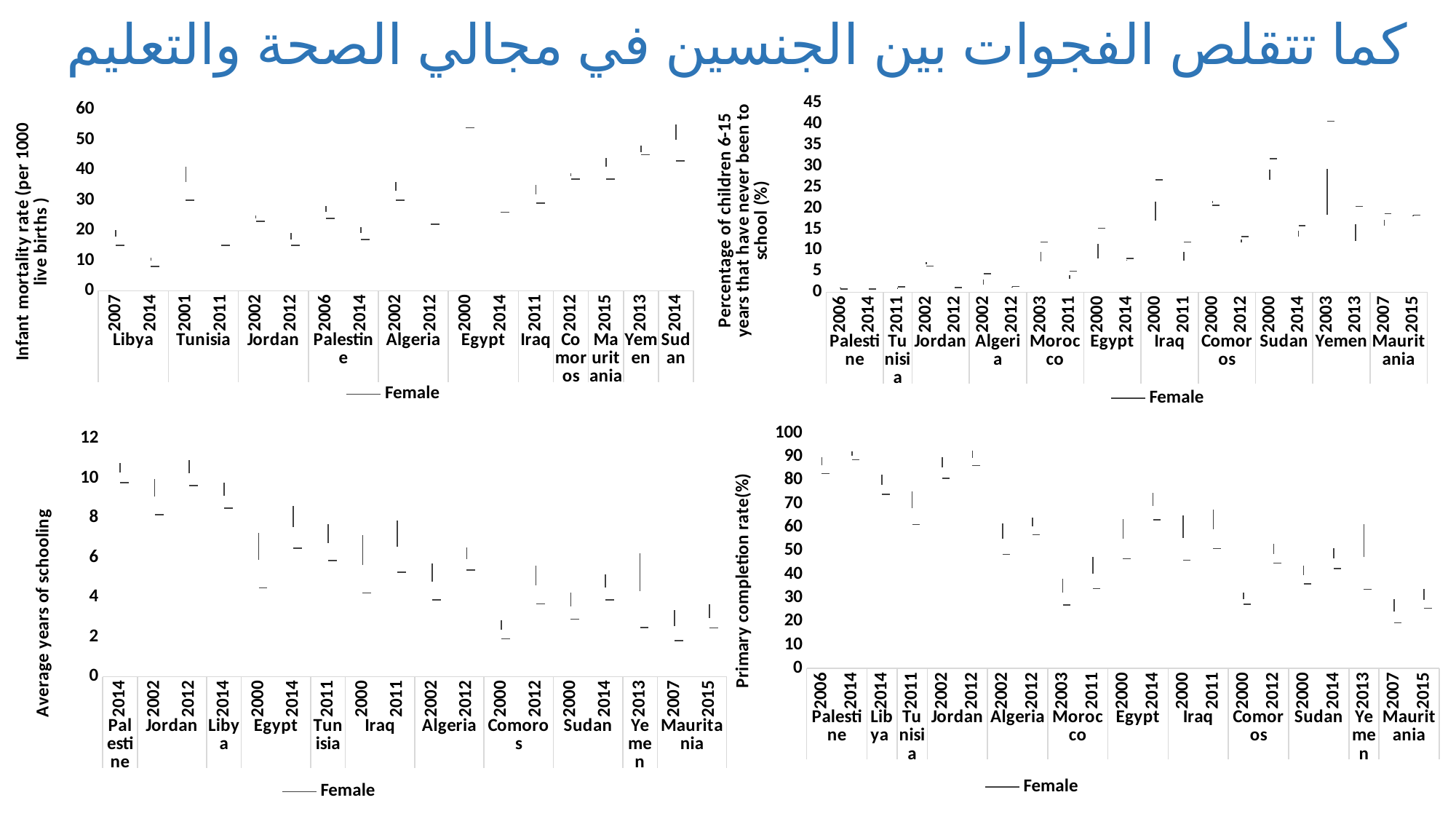
On the bottom-left chart (Average years of schooling), is the value for Comoros 2000 greater or less than 4? less On the bottom-right chart (Primary completion rate), is the value for Palestine 2014 greater or less than 80? greater On the bottom-left chart (Average years of schooling), is the value for Palestine 2014 greater or less than 8? greater On the top-left chart (Infant mortality rate), which is larger: the value for Libya 2007 or the value for Egypt 2000? Egypt 2000 What is the y-axis title of the top-left chart? Infant mortality rate (per 1000 live births ) On the bottom-right chart (Primary completion rate), how many countries are shown on the x axis? 12 How many series does the legend of the bottom-left chart (Average years of schooling) list? 1